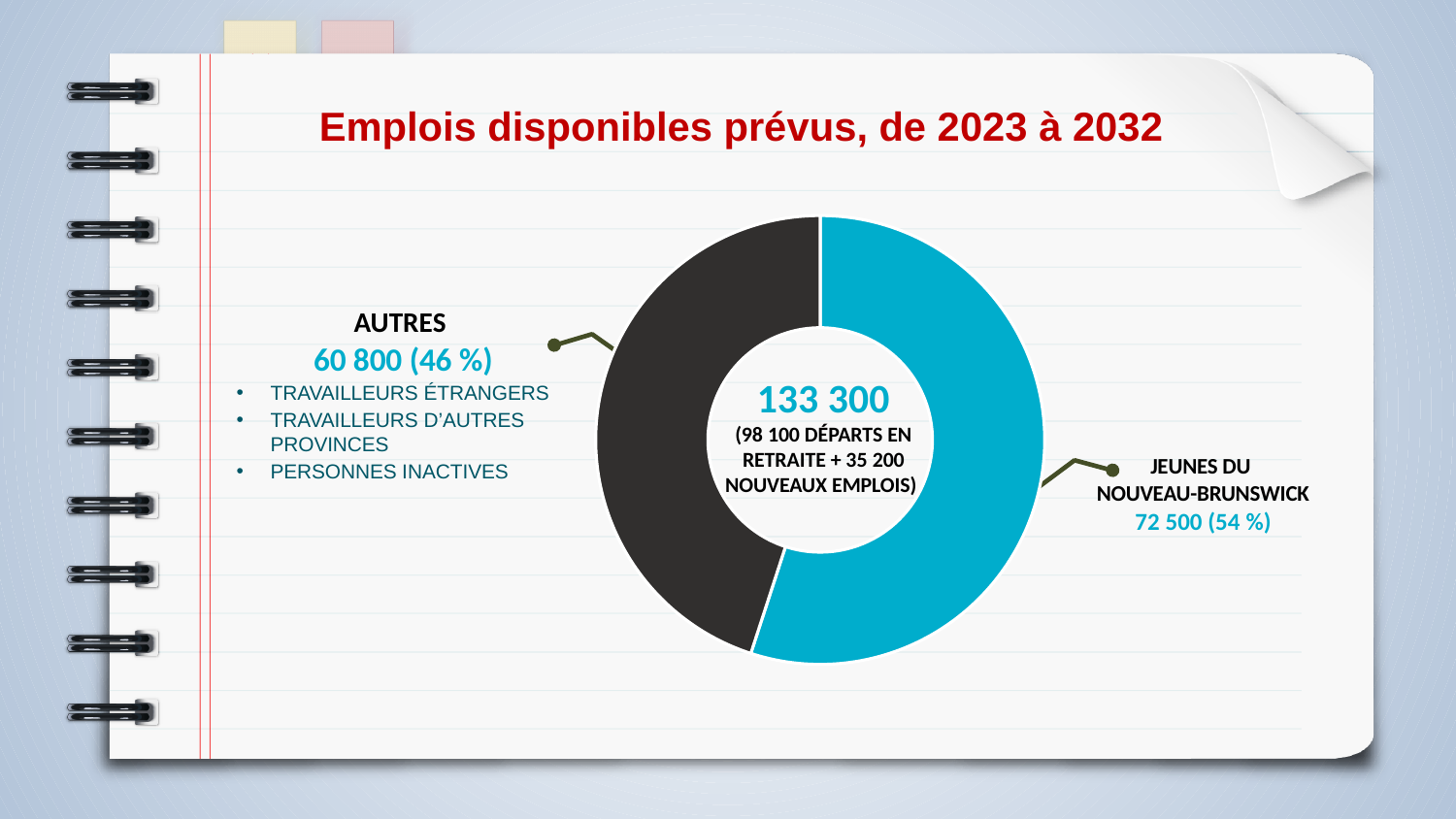
What is the difference between the values for Jeunes du Nouveau-Brunswick and Autres? 11 700 What is the title of the slide containing the chart? Emplois disponibles prévus, de 2023 à 2032 Which segment is the smallest in the chart? Autres Which colour represents the Jeunes du Nouveau-Brunswick segment? Blue What kind of chart is shown on the slide? Donut (pie) chart How many segments does the donut chart have? 2 What is the value shown for Jeunes du Nouveau-Brunswick? 72 500 What total is shown in the centre of the donut chart? 133 300 What is the value shown for Autres? 60 800 Which segment is the largest in the chart? Jeunes du Nouveau-Brunswick What share of the chart does Autres represent? 46 % What share of the chart does Jeunes du Nouveau-Brunswick represent? 54 %